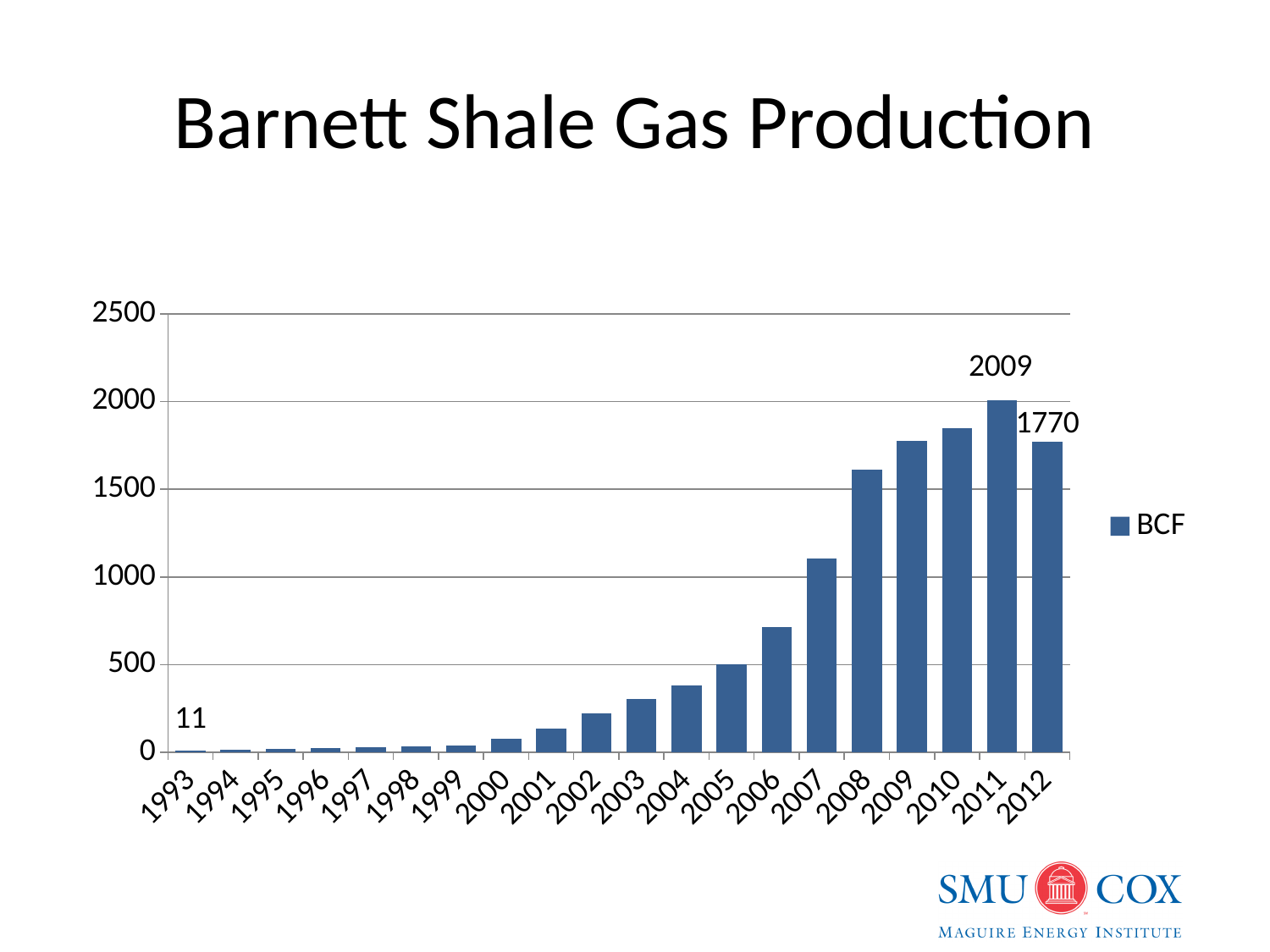
Which year has the highest value? 2011 What is the value for 1993? 11 What kind of chart is shown? bar chart Is the value for 2006 greater or less than 1000? less Which is larger, the value for 2011 or the value for 2012? 2011 What is the value for 2011? 2009 What is the difference between the values for 2011 and 2012? 239 What is the value for 2012? 1770 How many years are shown on the x axis? 20 Is the value for 2008 greater or less than 1500? greater Do the values generally rise or fall from 1993 to 2011? rise How many series does the legend list? 1